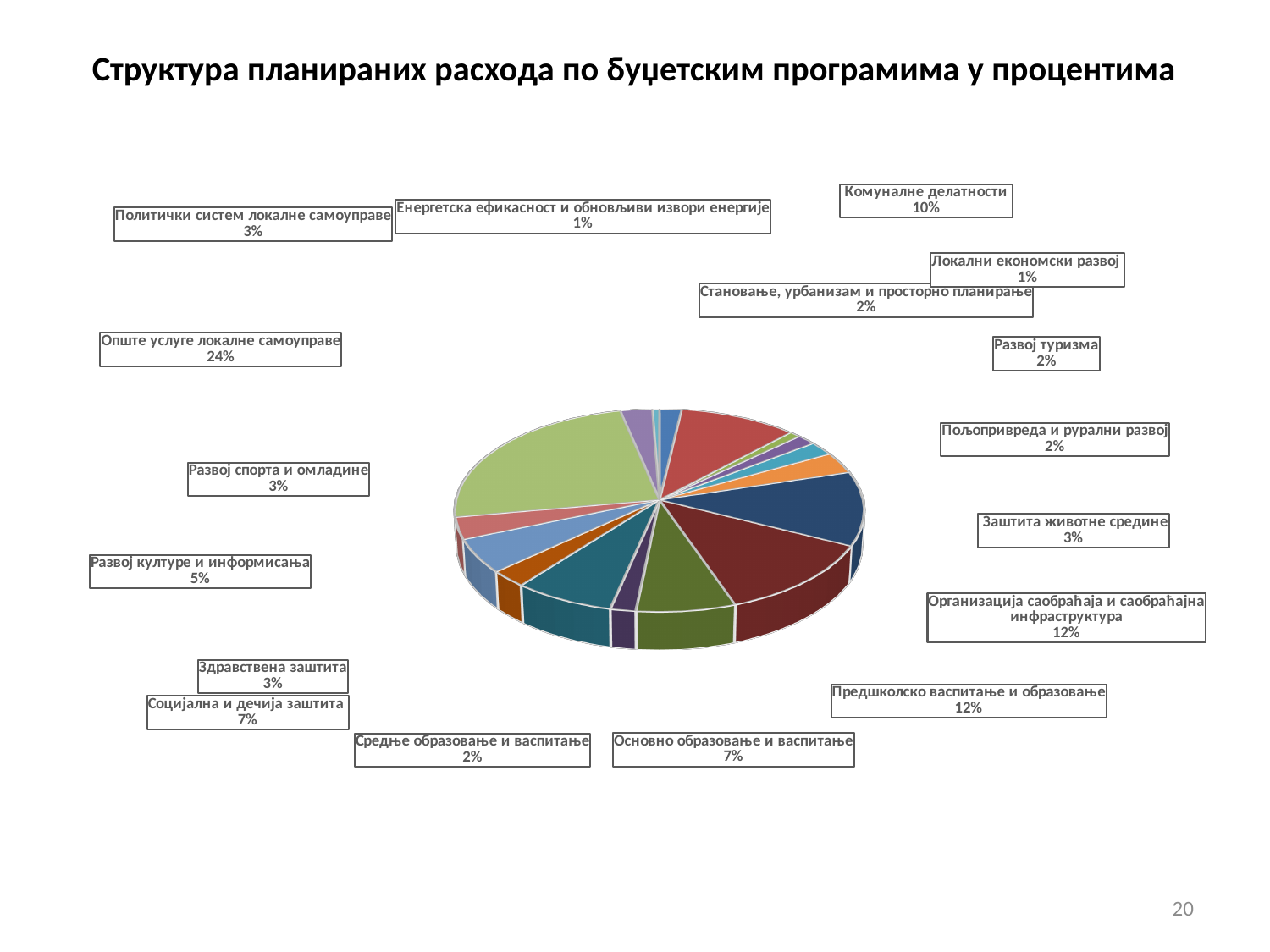
What percentage is shown for Развој културе и информисања? 5% What percentage is shown for Организација саобраћаја и саобраћајна инфраструктура? 12% What kind of chart is shown on the slide? pie chart Which budget program has the largest share of planned expenditures? Опште услуге локалне самоуправе What is the difference in percentage points between Опште услуге локалне самоуправе and Предшколско васпитање и образовање? 12 Which has a larger share: Комуналне делатности or Основно образовање и васпитање? Комуналне делатности What share of the pie does Здравствена заштита represent? 3% What percentage is shown for Социјална и дечија заштита? 7% What is the title of the chart? Структура планираних расхода по буџетским програмима у процентима How many budget programs (slices) are shown in the pie chart? 17 What percentage is shown for Комуналне делатности? 10% What percentage is shown for Опште услуге локалне самоуправе? 24%